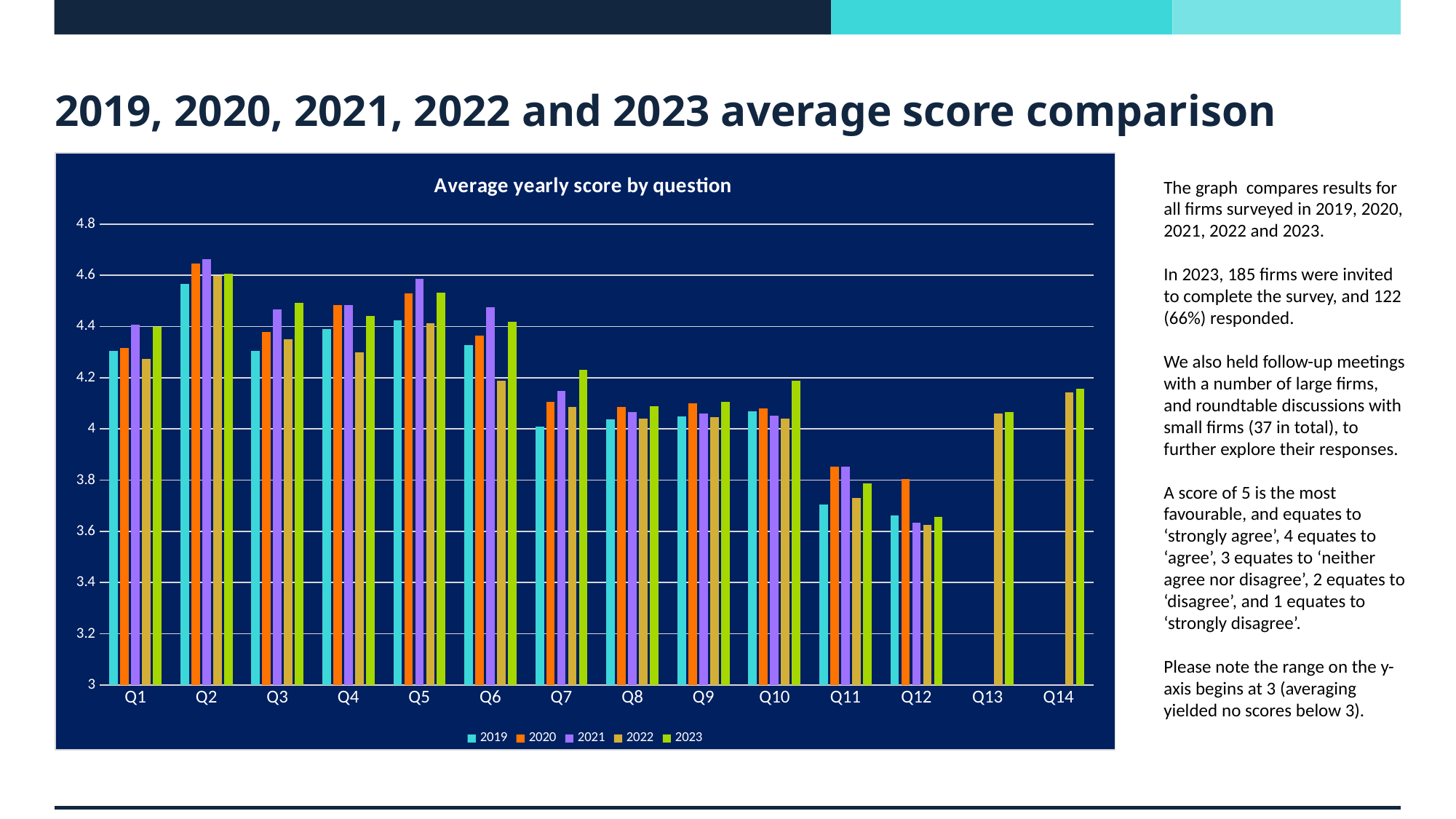
How many questions (categories) are shown on the x axis? 14 Is the 2023 value for Q10 greater or less than 4? greater Which years have bars plotted for Q13? 2022 and 2023 For Q7, which is larger: the 2019 value or the 2023 value? 2023 Which question has the highest 2023 value? Q2 Which question has the lowest 2019 value? Q12 What is the title of the chart? Average yearly score by question What kind of chart is shown on the slide? bar chart Is the 2019 value for Q12 greater or less than 3.8? less Is the 2022 value for Q4 greater or less than 4.4? less How many series does the legend list? 5